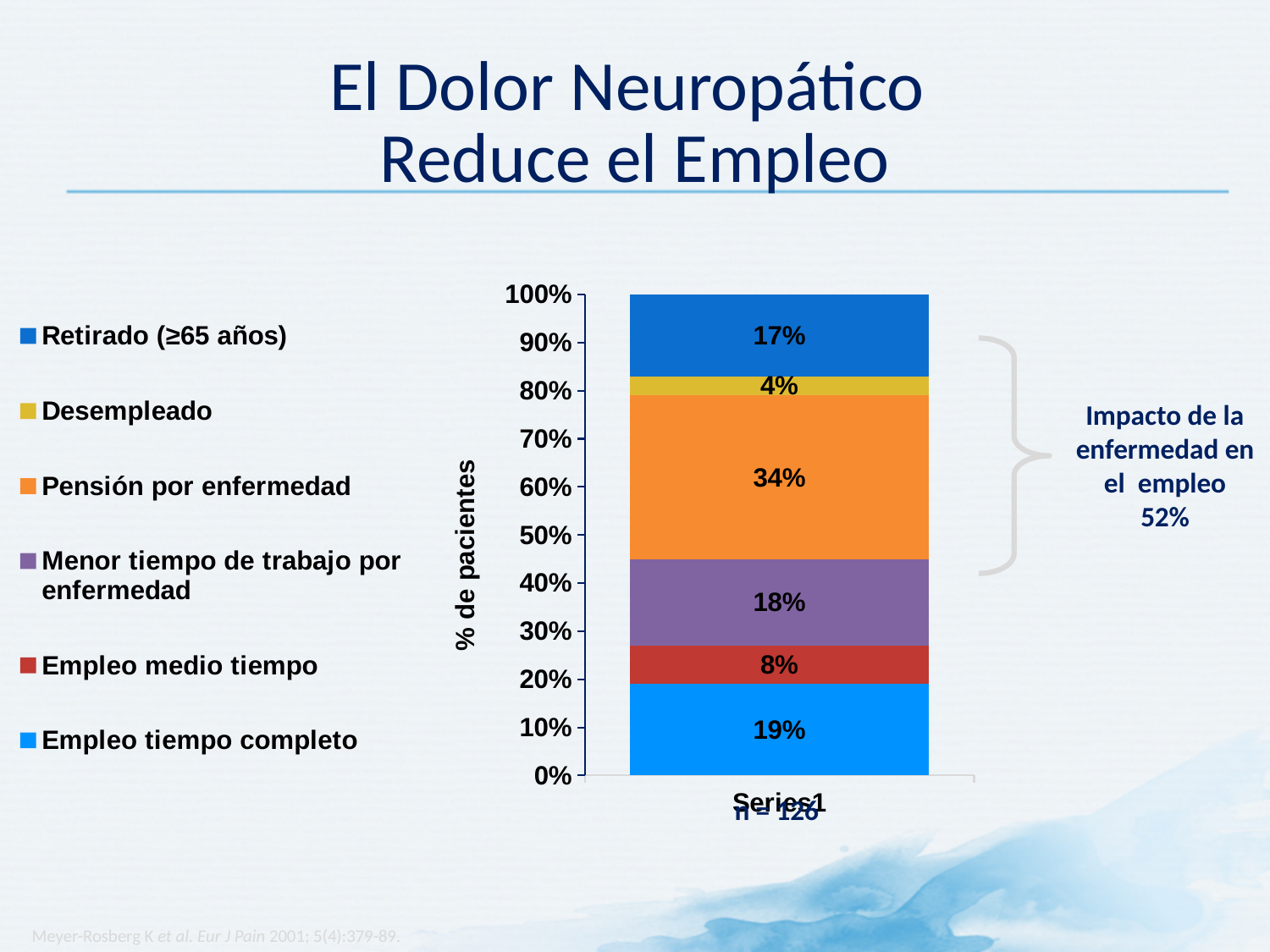
Which segment of the stacked bar has the smallest value? Desempleado What percentage of patients are in the 'Desempleado' segment? 4% What percentage of patients are in the 'Empleo tiempo completo' segment? 19% Which is larger, 'Empleo tiempo completo' or 'Empleo medio tiempo'? Empleo tiempo completo What kind of chart is shown on the slide? Stacked bar chart How many series does the legend list? 6 What percentage of patients are in the 'Retirado (≥65 años)' segment? 17% What is the difference between the 'Pensión por enfermedad' and 'Menor tiempo de trabajo por enfermedad' values? 16% Which segment of the stacked bar has the largest value? Pensión por enfermedad What percentage of patients are in the 'Pensión por enfermedad' segment? 34% What is the label of the vertical axis? % de pacientes What is the total of all segments in the stacked bar? 100%